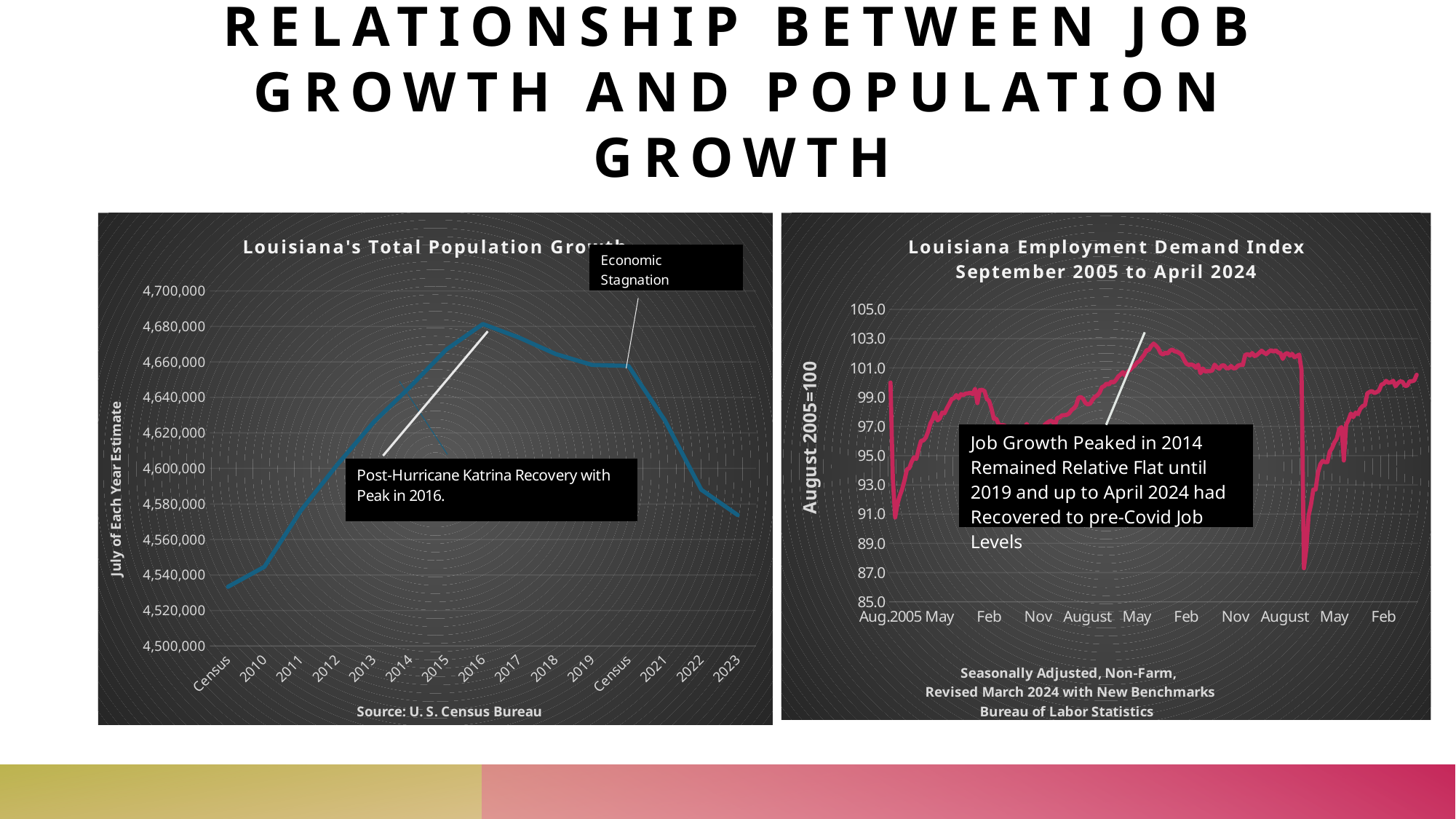
In "Louisiana's Total Population Growth", do the values rise or fall from 2019 to 2023? fall In "Louisiana's Total Population Growth", which year has the highest population estimate? 2016 How many category labels are shown on the x axis of "Louisiana's Total Population Growth"? 15 In "Louisiana's Total Population Growth", is the value for 2013 greater or less than 4,600,000? greater In "Louisiana's Total Population Growth", which is larger, the value for 2016 or the value for 2023? 2016 What kind of chart is "Louisiana Employment Demand Index September 2005 to April 2024"? line chart What is the y-axis label of the "Louisiana Employment Demand Index" chart? August 2005=100 What kind of chart is "Louisiana's Total Population Growth"? line chart In "Louisiana's Total Population Growth", is the value for 2023 greater or less than 4,580,000? less What source is cited below "Louisiana's Total Population Growth"? U. S. Census Bureau In "Louisiana's Total Population Growth", is the value for 2016 greater or less than 4,660,000? greater